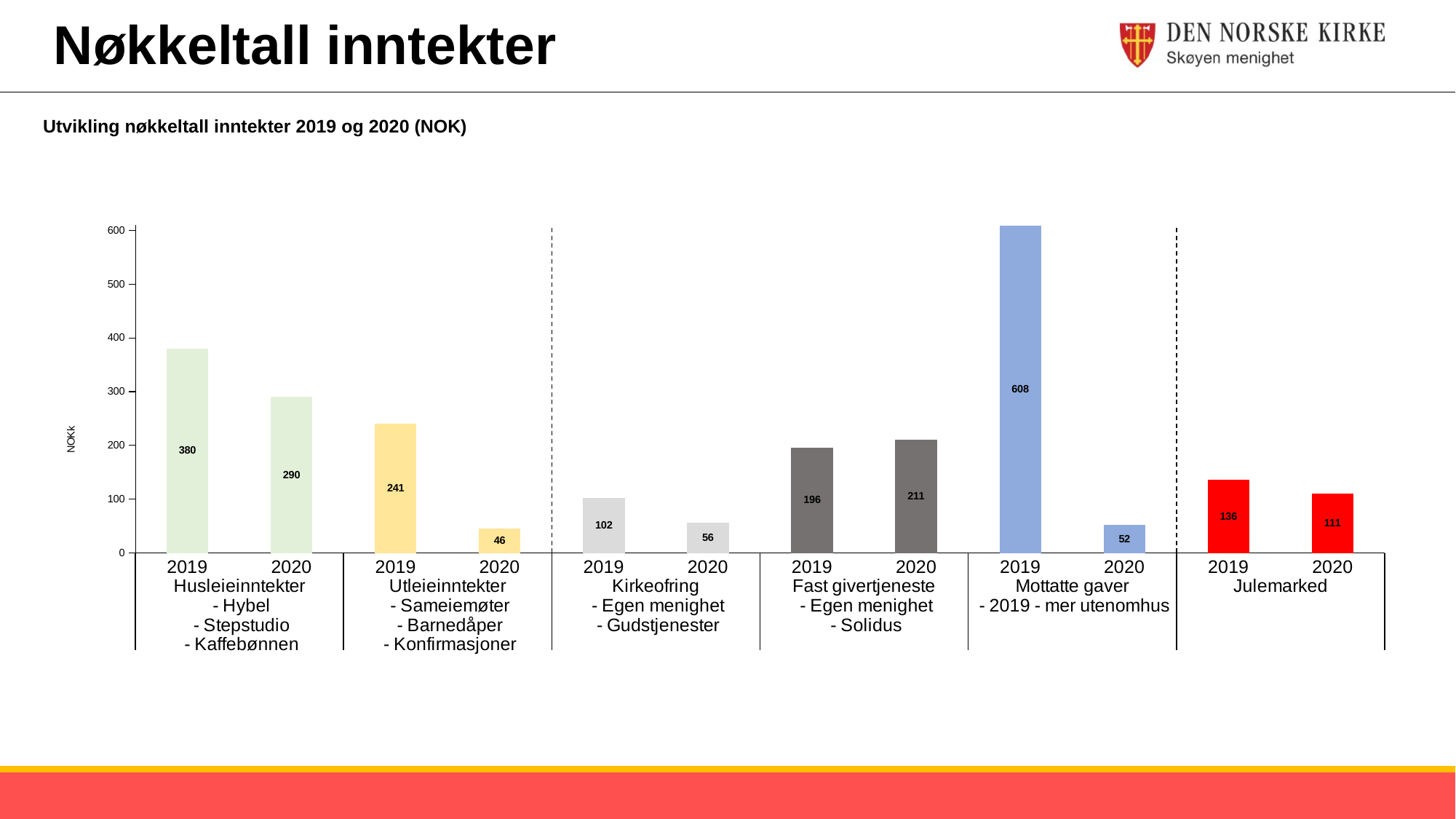
What is the difference between the 2019 and 2020 values for Kirkeofring? 46 How many income categories are shown on the x axis of the chart? 6 Which bar in the chart has the highest value? Mottatte gaver 2019 What is the 2020 value for Utleieinntekter? 46 What is the 2019 value for Husleieinntekter? 380 What is the difference between the 2019 and 2020 values for Mottatte gaver? 556 What is the 2019 value for Mottatte gaver? 608 What is the 2020 value for Fast givertjeneste? 211 Which is larger for Fast givertjeneste, the 2019 value or the 2020 value? 2020 Which bar in the chart has the lowest value? Utleieinntekter 2020 Is the 2019 value for Julemarked greater or less than 100? greater What kind of chart is shown on the slide? Bar chart